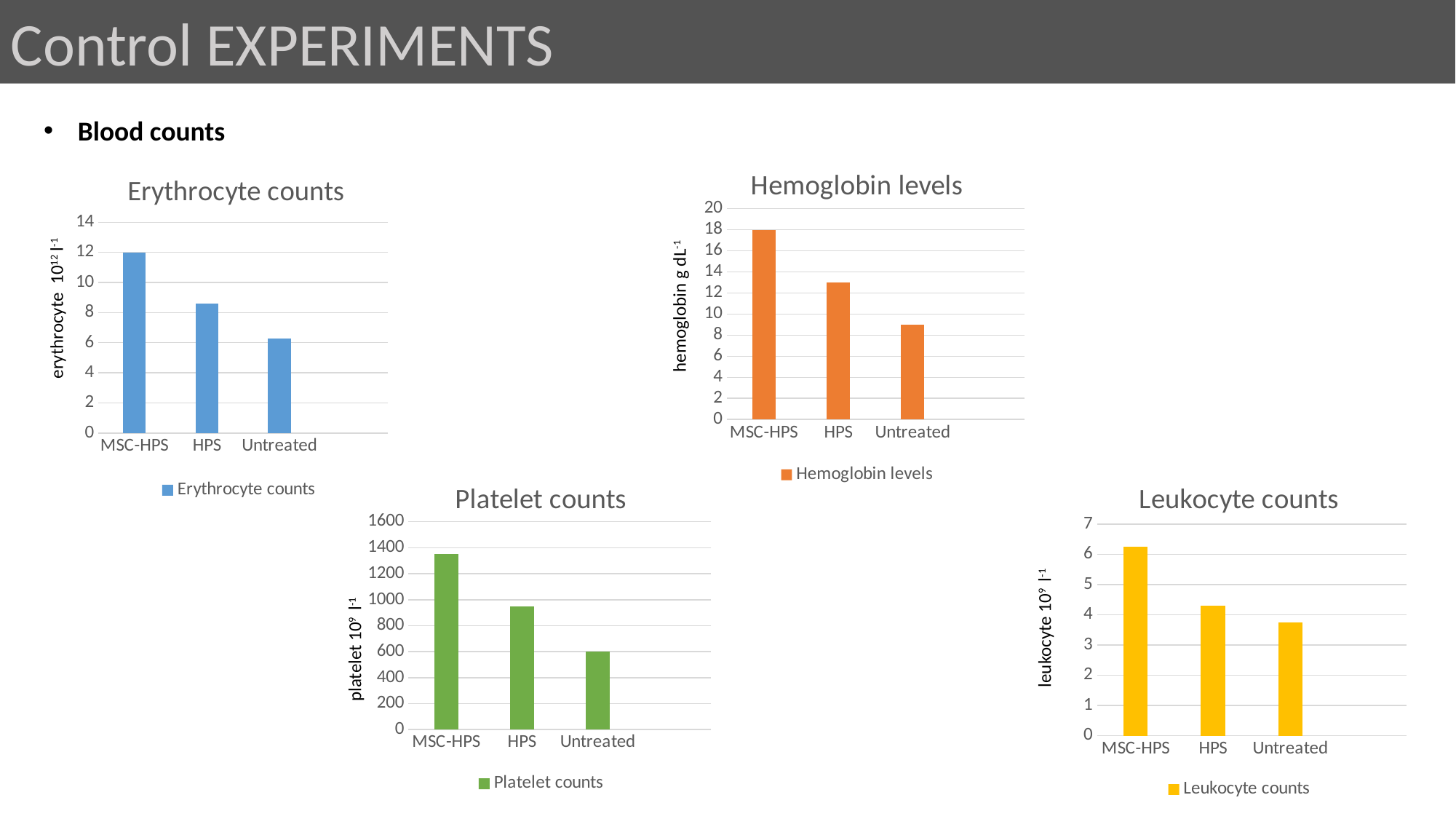
How many categories are shown in the Hemoglobin levels chart? 3 In the Platelet counts chart, which category has the lowest value? Untreated In the Leukocyte counts chart, which category has the highest value? MSC-HPS In the Leukocyte counts chart, is the value for Untreated greater or less than 4? less In the Platelet counts chart, do the values rise or fall from MSC-HPS to Untreated? fall What kind of chart is the Leukocyte counts chart? bar chart In the Erythrocyte counts chart, which is larger, the value for HPS or the value for Untreated? HPS In the Hemoglobin levels chart, what is the value for MSC-HPS? 18 In the Erythrocyte counts chart, what is the value for MSC-HPS? 12 In the Platelet counts chart, what is the value for Untreated? 600 In the Platelet counts chart, is the value for HPS greater or less than 1000? less In the Hemoglobin levels chart, is the value for HPS greater or less than 12? greater